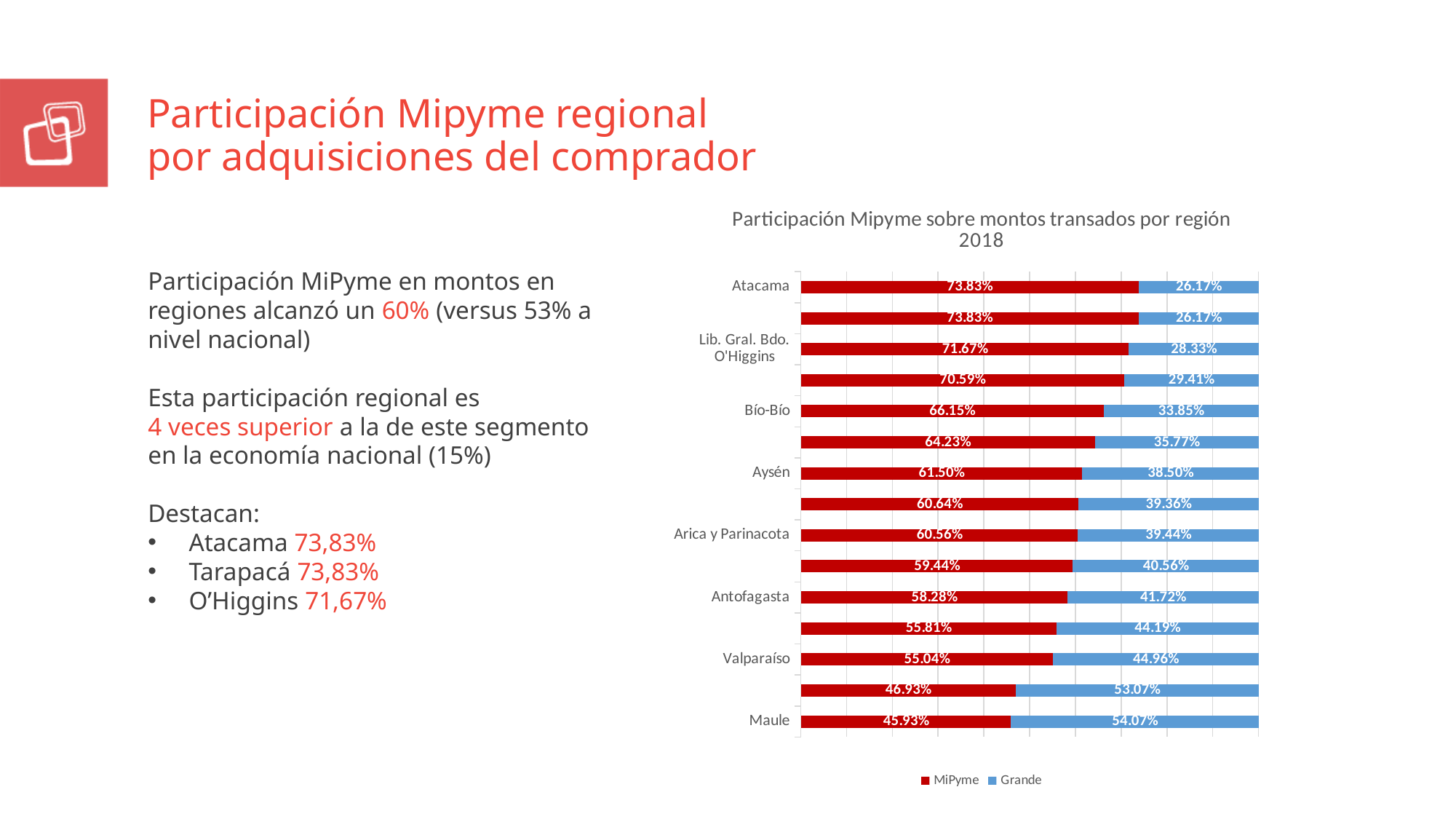
Which labeled region has the highest Grande share? Maule What is the Grande share for Lib. Gral. Bdo. O'Higgins? 28.33% What is the MiPyme share for Bío-Bío? 66.15% What is the difference between the MiPyme share of Atacama and that of Maule? 27.90 percentage points What is the Grande share for Maule? 54.07% Which is larger for Valparaíso, the MiPyme share or the Grande share? MiPyme How many series does the legend list? 2 What is the title of the chart? Participación Mipyme sobre montos transados por región 2018 What kind of chart is shown? Stacked bar chart Which labeled region has the lowest MiPyme share? Maule What is the MiPyme share for Atacama? 73.83% What is the total of the stacked bar for Aysén? 100%